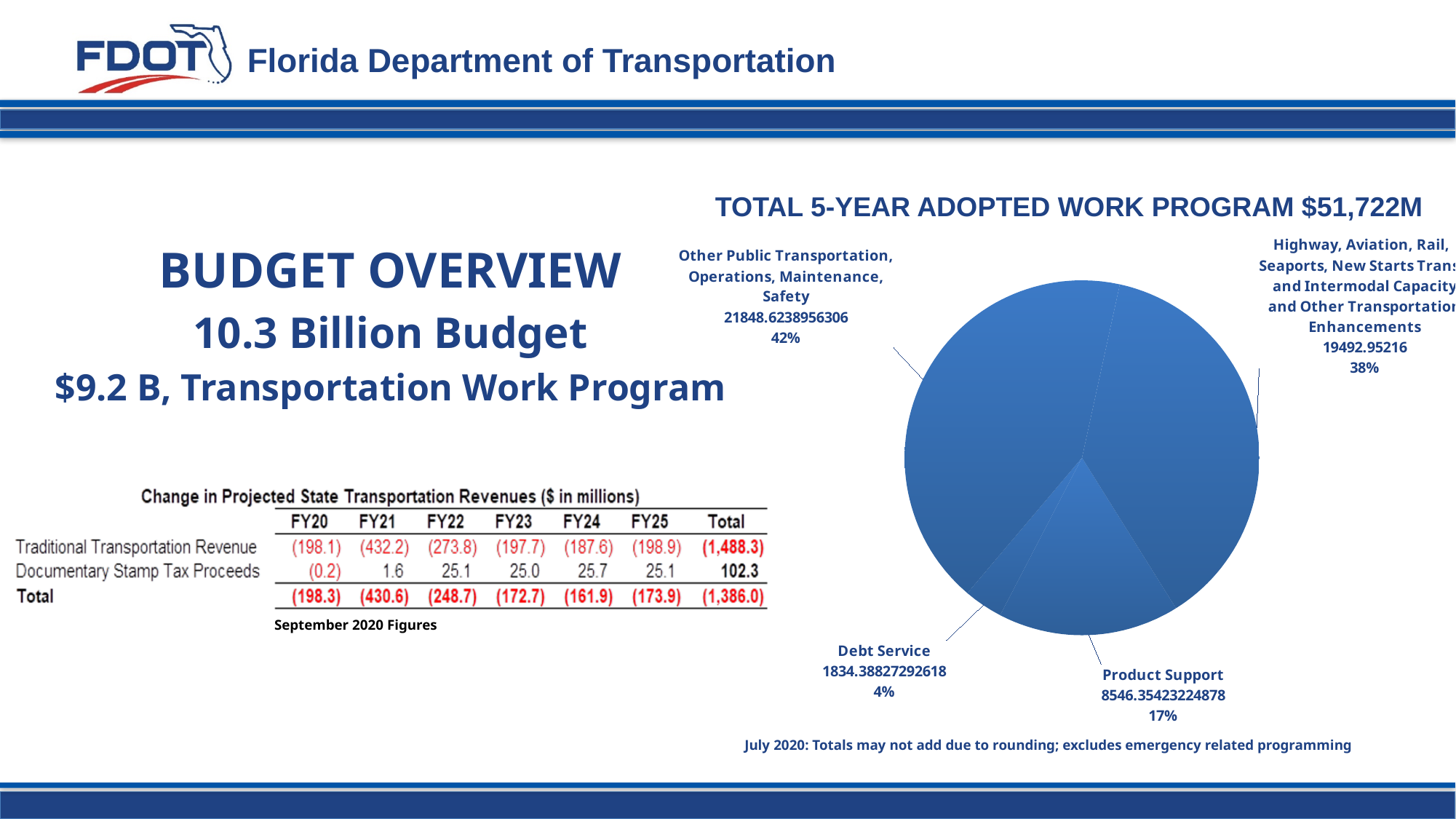
What value is shown for Product Support in the pie chart? 8546.35423224878 Which is larger in the pie chart: Product Support or Debt Service? Product Support What share of the pie does Debt Service represent? 4% What kind of chart is shown under the title "TOTAL 5-YEAR ADOPTED WORK PROGRAM $51,722M"? Pie chart What value is shown for Other Public Transportation, Operations, Maintenance, Safety in the pie chart? 21848.6238956306 What share of the pie does Other Public Transportation, Operations, Maintenance, Safety represent? 42% What share of the pie does Product Support represent? 17% What is the title of the pie chart? TOTAL 5-YEAR ADOPTED WORK PROGRAM $51,722M Which slice of the pie chart is the smallest? Debt Service What value is shown for Debt Service in the pie chart? 1834.38827292618 Which slice of the pie chart is the largest? Other Public Transportation, Operations, Maintenance, Safety How many slices does the pie chart have? 4